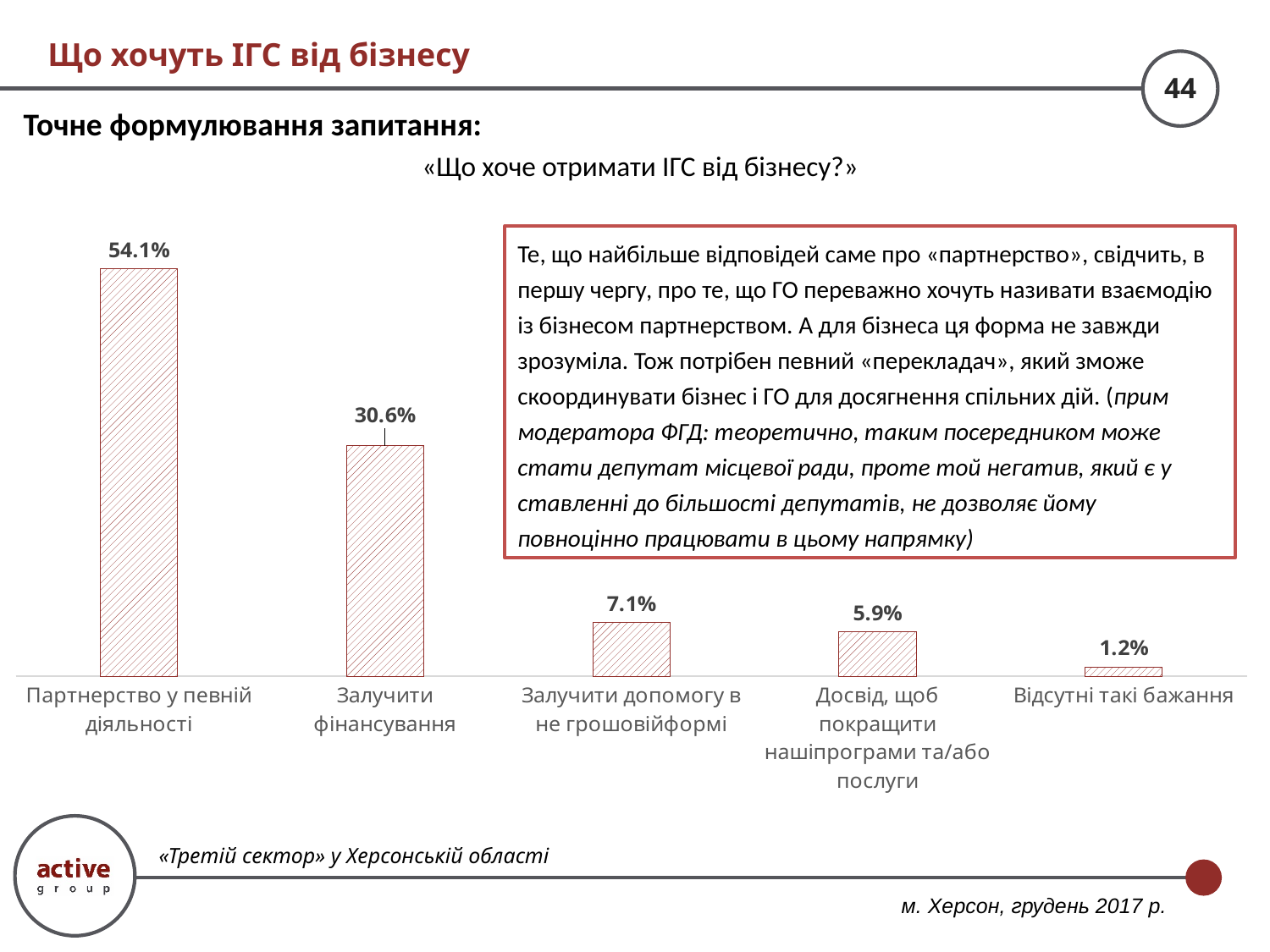
What is the value for «Відсутні такі бажання»? 1.2% What is the value for «Залучити допомогу в не грошовій формі»? 7.1% How many categories are shown in the chart? 5 What is the difference between «Партнерство у певній діяльності» and «Залучити фінансування»? 23.5% Do the values rise or fall from left to right along the x axis? Fall Which is larger: «Залучити допомогу в не грошовій формі» or «Досвід, щоб покращити наші програми та/або послуги»? Залучити допомогу в не грошовій формі What kind of chart is shown on the slide? Bar chart What is the value for «Партнерство у певній діяльності»? 54.1% Which category has the highest value? Партнерство у певній діяльності What is the value for «Залучити фінансування»? 30.6% Which category has the lowest value? Відсутні такі бажання What is the value for «Досвід, щоб покращити наші програми та/або послуги»? 5.9%